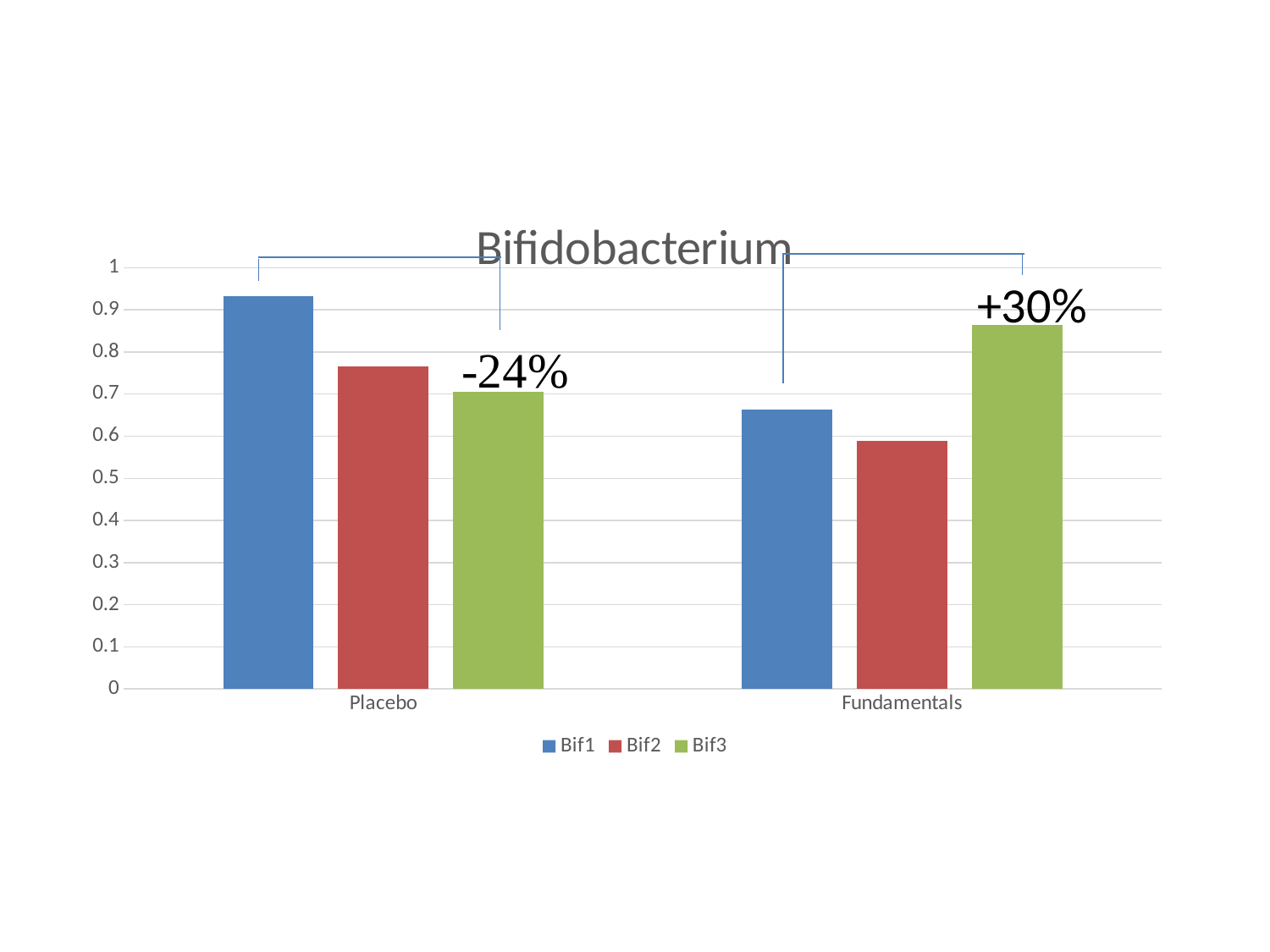
Which series has the highest value in the Fundamentals category? Bif3 What is the title of the chart? Bifidobacterium Which is larger: Bif3 in Fundamentals or Bif3 in Placebo? Bif3 in Fundamentals Is the value for Bif1 in the Placebo category greater or less than 0.9? greater Which is larger: Bif1 in Placebo or Bif1 in Fundamentals? Bif1 in Placebo Which series has the highest value in the Placebo category? Bif1 What kind of chart is shown on the slide? bar chart How many series does the legend list? 3 Which series has the lowest value in the Fundamentals category? Bif2 What percentage change is annotated above the Fundamentals group? +30% How many categories are shown on the x axis? 2